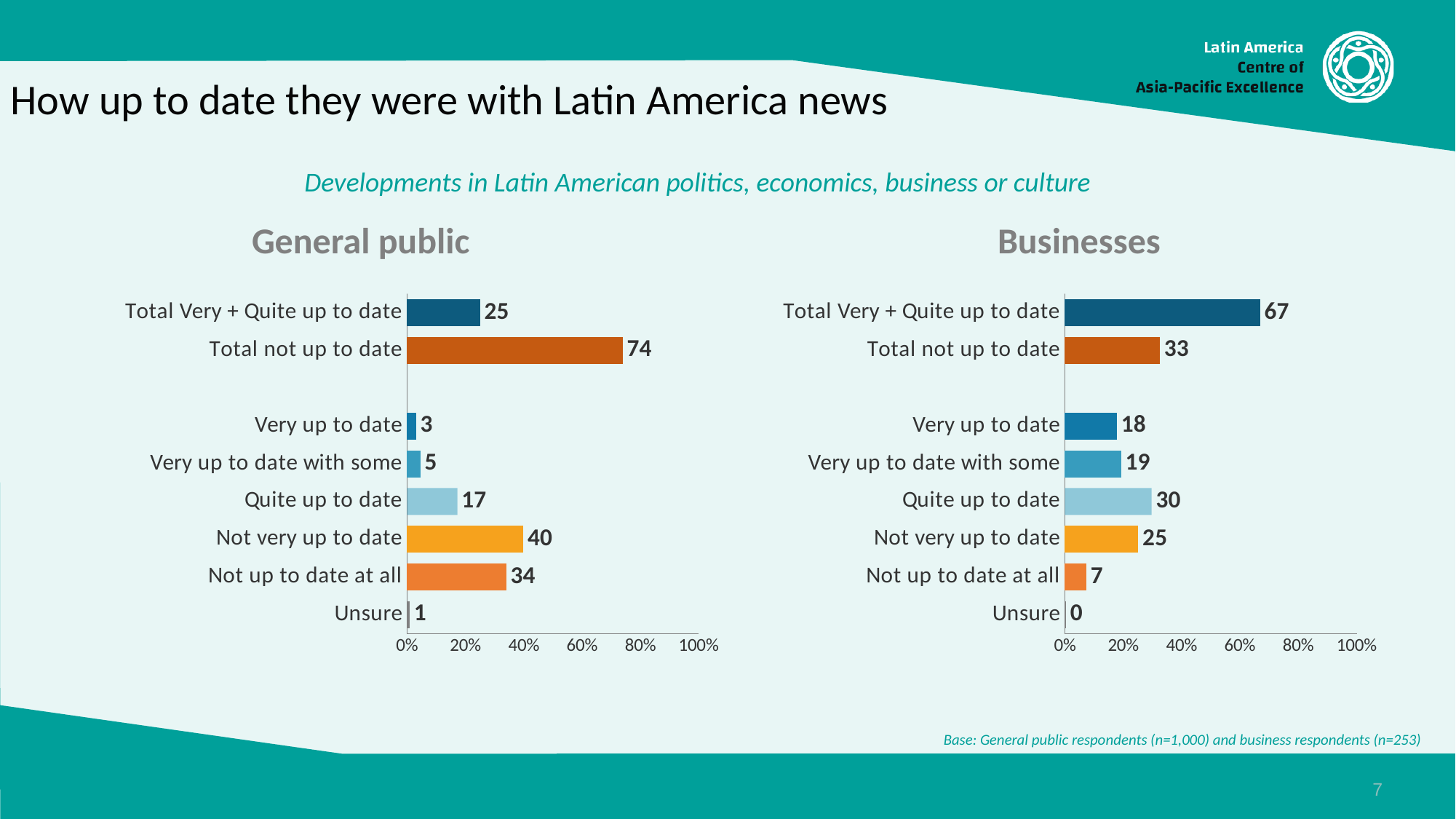
In the General public chart, what is the value for Not very up to date? 40 In the Businesses chart, what is the difference between Total Very + Quite up to date and Total not up to date? 34 What kind of chart is the General public chart? bar chart In the Businesses chart, what is the value for Quite up to date? 30 How many categories are plotted in the Businesses chart? 8 Which is larger: Very up to date in the General public chart or Very up to date in the Businesses chart? Businesses In the Businesses chart, which category has the lowest value? Unsure What is the subtitle shown above the two charts? Developments in Latin American politics, economics, business or culture In the General public chart, what is the difference between Not very up to date and Not up to date at all? 6 In the General public chart, which category has the highest value? Total not up to date In the Businesses chart, what is the value for Total Very + Quite up to date? 67 In the General public chart, is the value for Total not up to date greater or less than 60%? greater